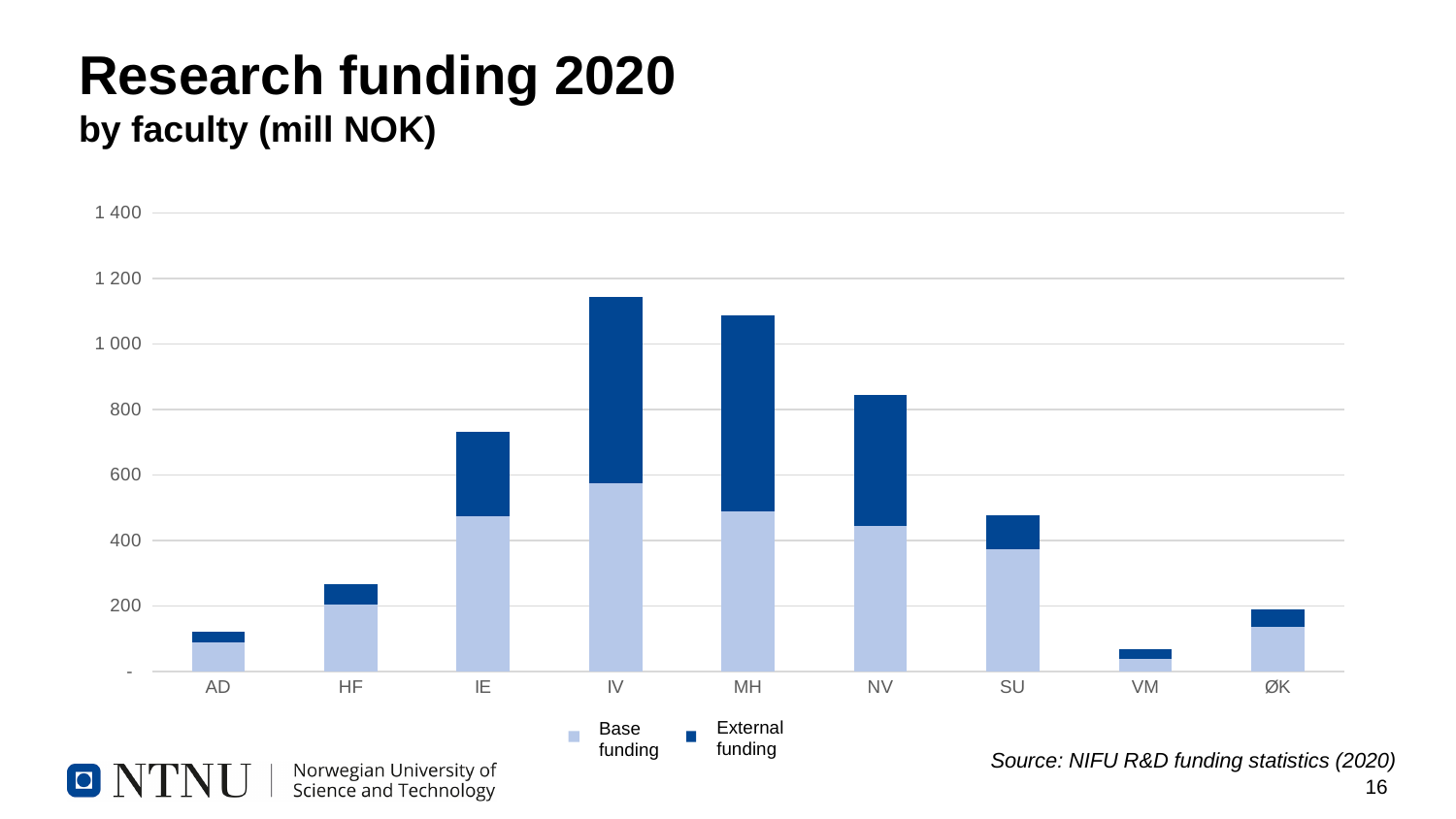
What are the two series named in the chart's legend? Base funding and External funding What kind of chart is shown on the slide? Stacked bar chart Which faculty has the larger total funding, HF or ØK? HF Which faculty has the lowest total research funding in the chart? VM Which faculty has the larger total funding, IE or NV? NV Is the total funding for SU greater or less than 600? less Is the total funding for IV greater or less than 1 000? greater How many faculties are shown on the x axis of the chart? 9 Is the total funding for NV greater or less than 800? greater How many series does the chart's legend list? 2 Which faculty has the highest total research funding in the chart? IV